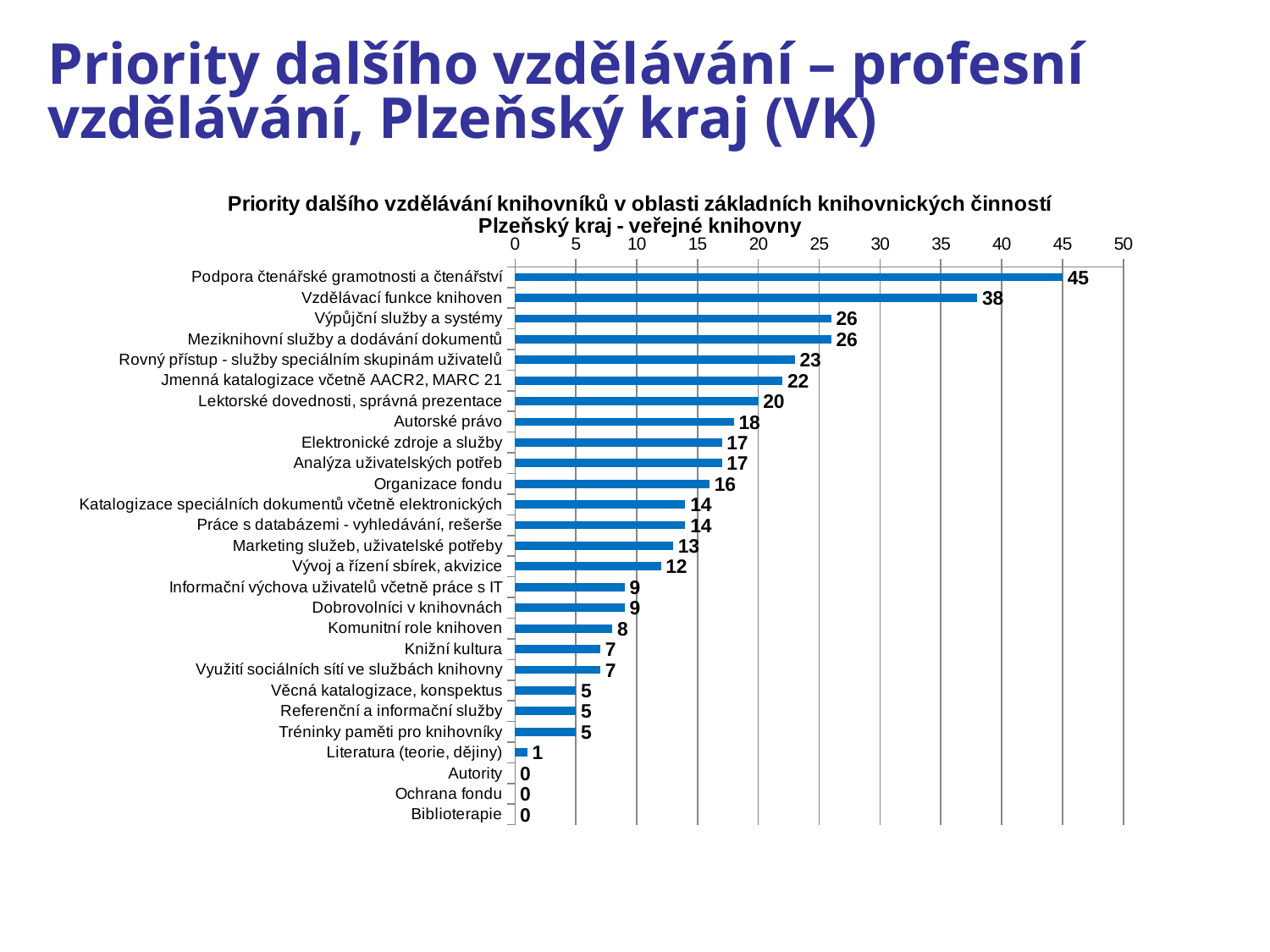
How many categories are shown in the chart? 27 What kind of chart is shown on the slide? Bar chart How many categories have a value of 0? 3 Which category has the highest value? Podpora čtenářské gramotnosti a čtenářství What is the value for Komunitní role knihoven? 8 Which is larger, the value for Organizace fondu or the value for Marketing služeb, uživatelské potřeby? Organizace fondu What is the difference between the values for Podpora čtenářské gramotnosti a čtenářství and Vzdělávací funkce knihoven? 7 What is the highest value shown on the horizontal axis? 50 What is the value for Literatura (teorie, dějiny)? 1 What is the difference between the values for Rovný přístup - služby speciálním skupinám uživatelů and Jmenná katalogizace včetně AACR2, MARC 21? 1 What is the value for Autorské právo? 18 What is the value for Podpora čtenářské gramotnosti a čtenářství? 45